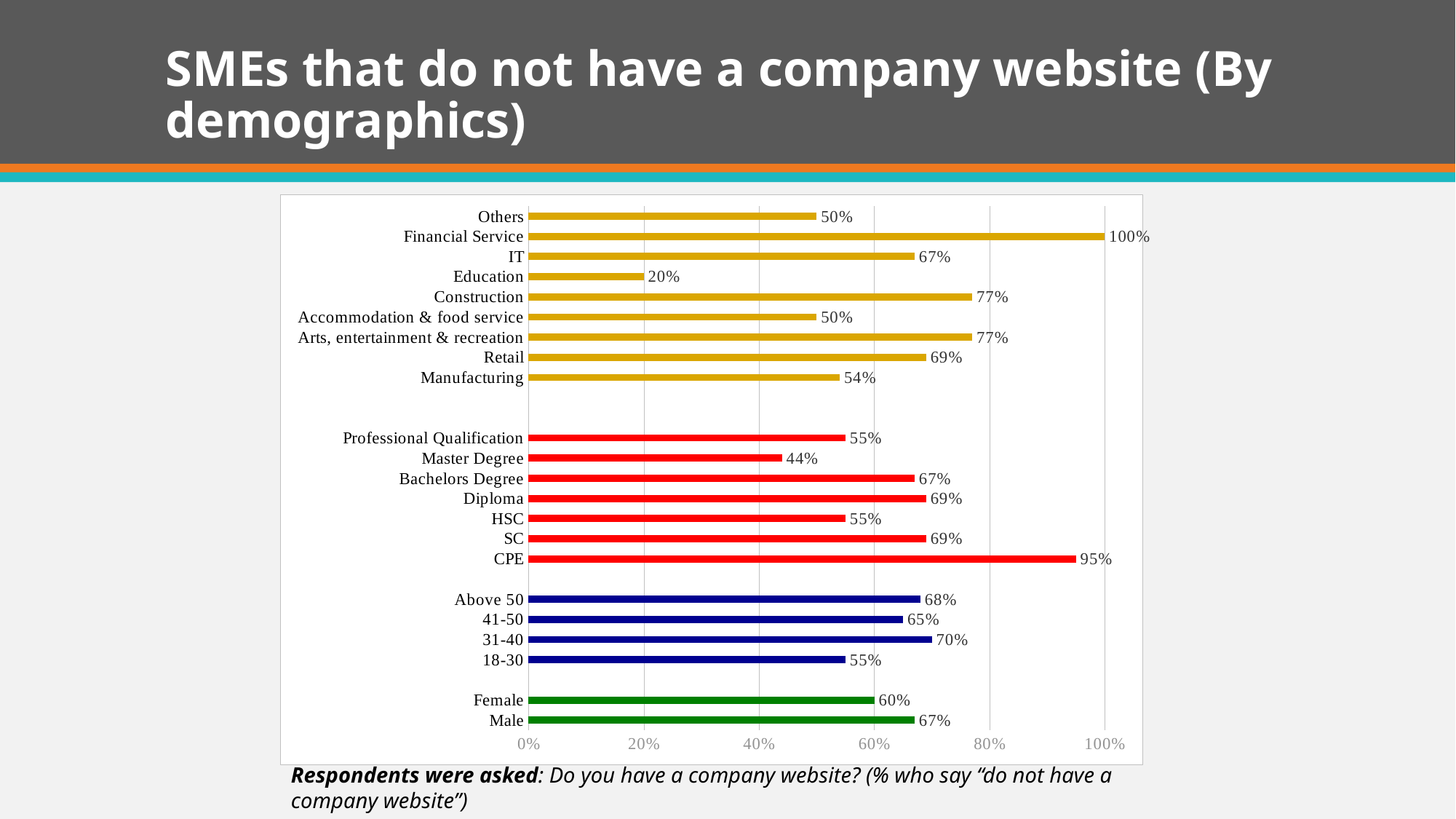
What is the difference between the values for Male and Female? 7% Which is larger, the value for 31-40 or the value for 18-30? 31-40 Which category has the lowest value? Education What is the difference between the values for CPE and Master Degree? 51% Is the value for Construction greater or less than 60%? greater What is the value for CPE? 95% How many categories are plotted in the chart? 22 What is the value for Financial Service? 100% What is the value for Education? 20% Which category has the highest value? Financial Service What kind of chart is shown on the slide? bar chart What is the value for Female? 60%